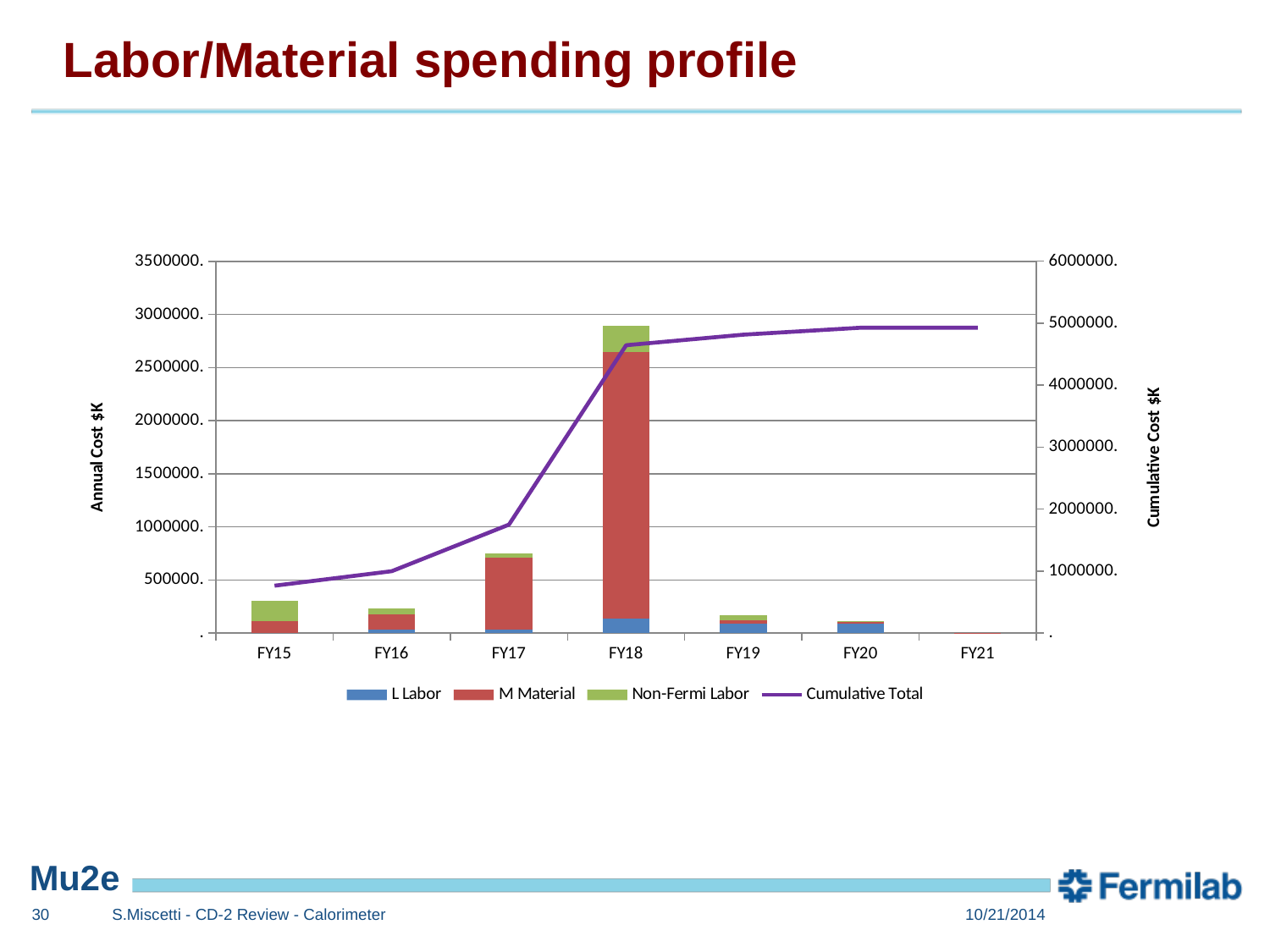
Which fiscal year has the smallest stacked bar? FY21 Is the total stacked bar for FY17 greater or less than 1000000? less Which has the larger total stacked bar, FY16 or FY17? FY17 What kind of chart is used for the L Labor, M Material and Non-Fermi Labor series? Stacked bar chart Which fiscal year has the tallest stacked bar? FY18 Is the Cumulative Total at FY20 greater or less than 4000000 on the right axis? greater How many fiscal years are shown on the x axis of the chart? 7 What is the title of the chart on this slide? Labor/Material spending profile Does the Cumulative Total line rise or fall from FY15 to FY21? rise How many series does the chart legend list? 4 Is the Cumulative Total at FY15 greater or less than 1000000 on the right axis? less